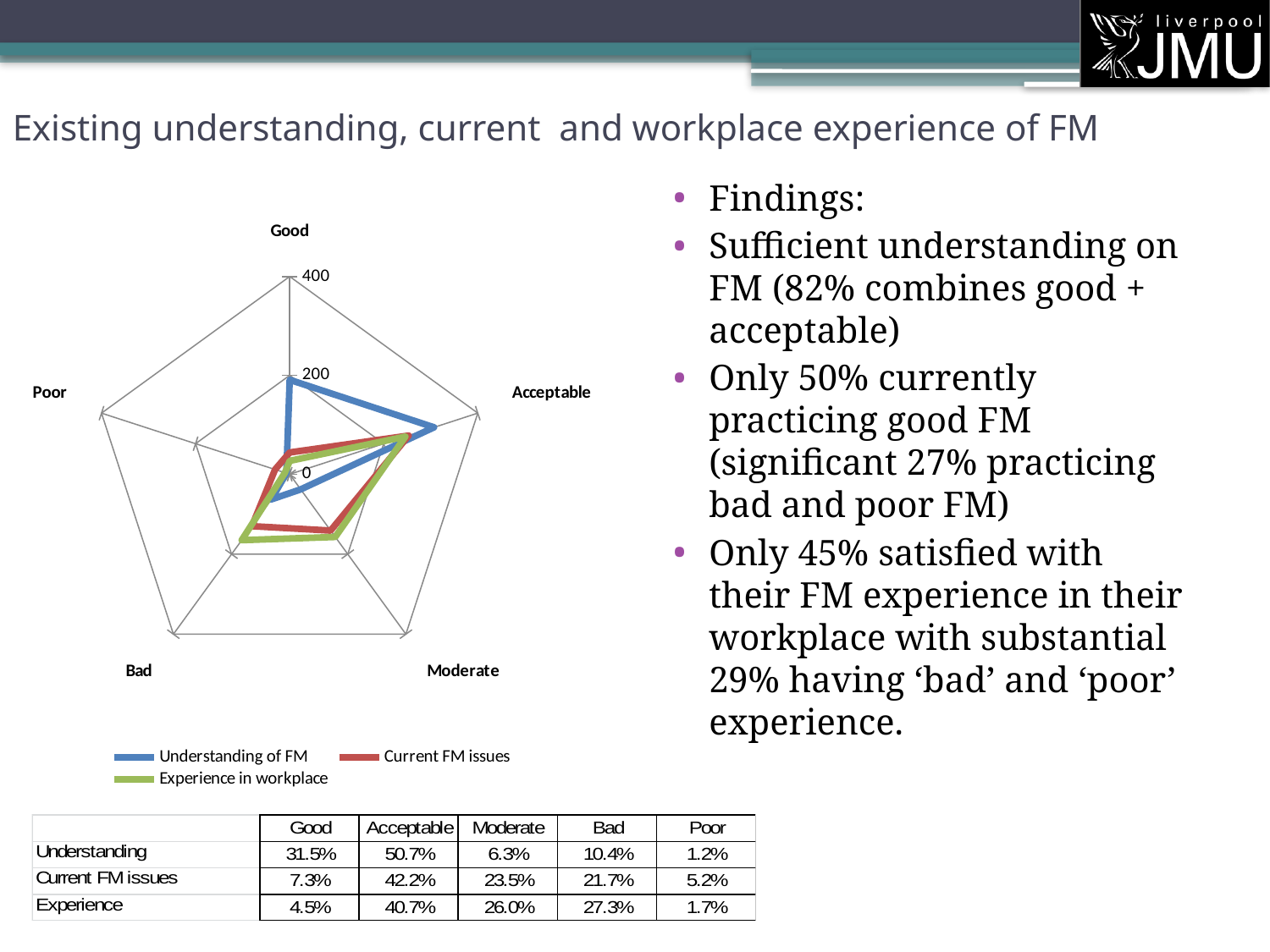
How many categories (axes) does the radar chart have? 5 What kind of chart is shown on the slide? Radar chart For the Understanding of FM series, which category has the lowest value? Poor Which series are listed in the chart's legend? Understanding of FM, Current FM issues, Experience in workplace Is the value for Understanding of FM at Acceptable greater or less than 200? greater At the Good category, which series has the larger value: Understanding of FM or Experience in workplace? Understanding of FM Is the value for Understanding of FM at Moderate greater or less than 200? less For the Understanding of FM series, which category has the highest value? Acceptable How many series does the chart's legend list? 3 For the Experience in workplace series, which category has the highest value? Acceptable What is the highest value shown on the chart's radial axis? 400 Is the value for Experience in workplace at Bad greater or less than 200? less